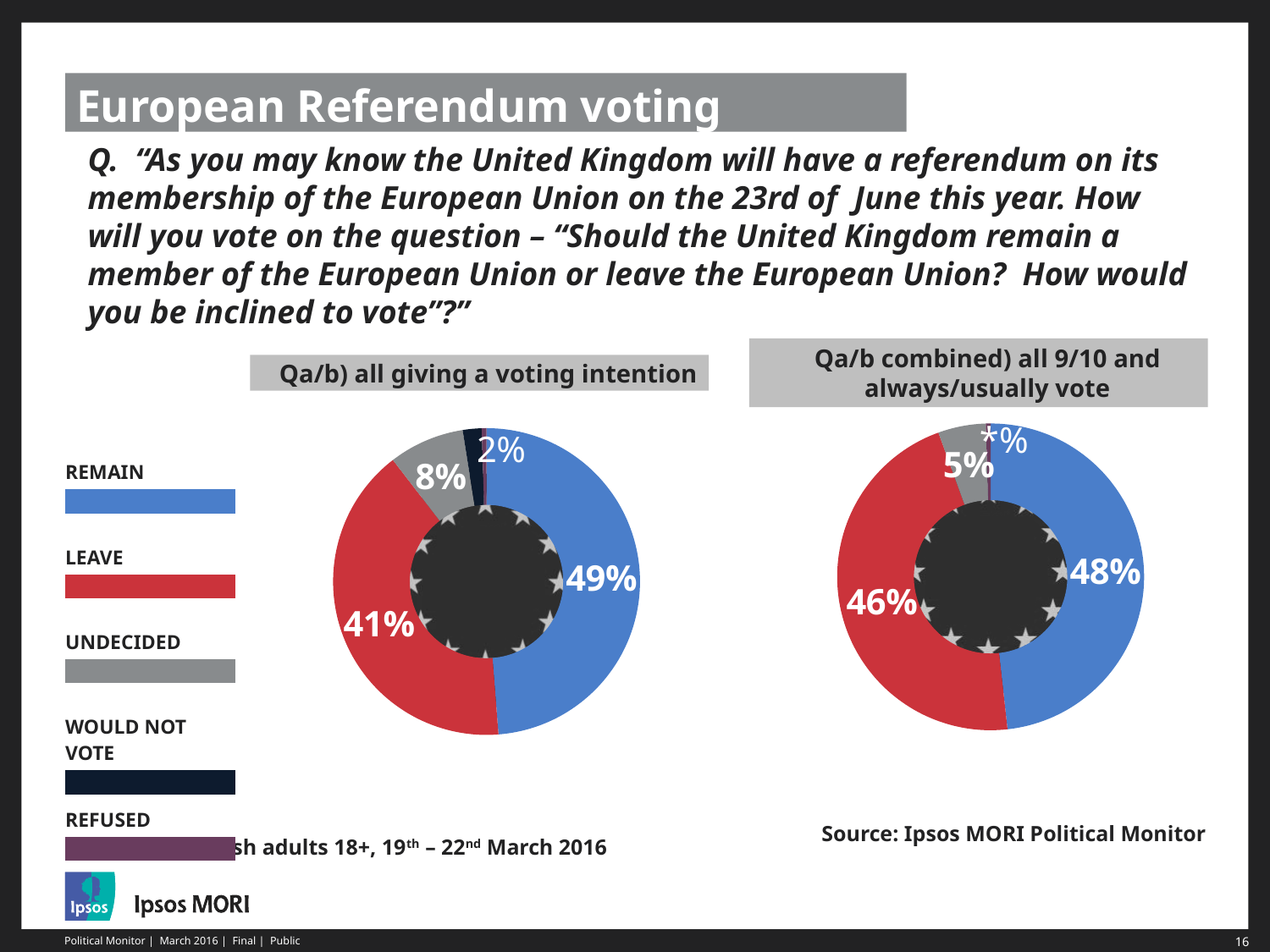
In the 'Qa/b) all giving a voting intention' chart, what percentage is shown for Remain? 49% In the 'Qa/b) all giving a voting intention' chart, what percentage is shown for Leave? 41% In the 'Qa/b) all giving a voting intention' chart, what is the difference in percentage points between Remain and Leave? 8 In the 'Qa/b combined) all 9/10 and always/usually vote' chart, what is the difference in percentage points between Remain and Leave? 2 In the 'Qa/b) all giving a voting intention' chart, what percentage is shown for Undecided? 8% In the 'Qa/b combined) all 9/10 and always/usually vote' chart, what percentage is shown for Remain? 48% What kind of chart is used on this slide to show the voting intention results? Pie (doughnut) chart In the 'Qa/b combined) all 9/10 and always/usually vote' chart, what percentage is shown for Leave? 46% How many categories does the legend on the left of the slide list? 5 In the 'Qa/b) all giving a voting intention' chart, which category has the largest share? Remain In the 'Qa/b) all giving a voting intention' chart, what percentage is shown for Would not vote? 2% In the 'Qa/b combined) all 9/10 and always/usually vote' chart, what percentage is shown for Undecided? 5%